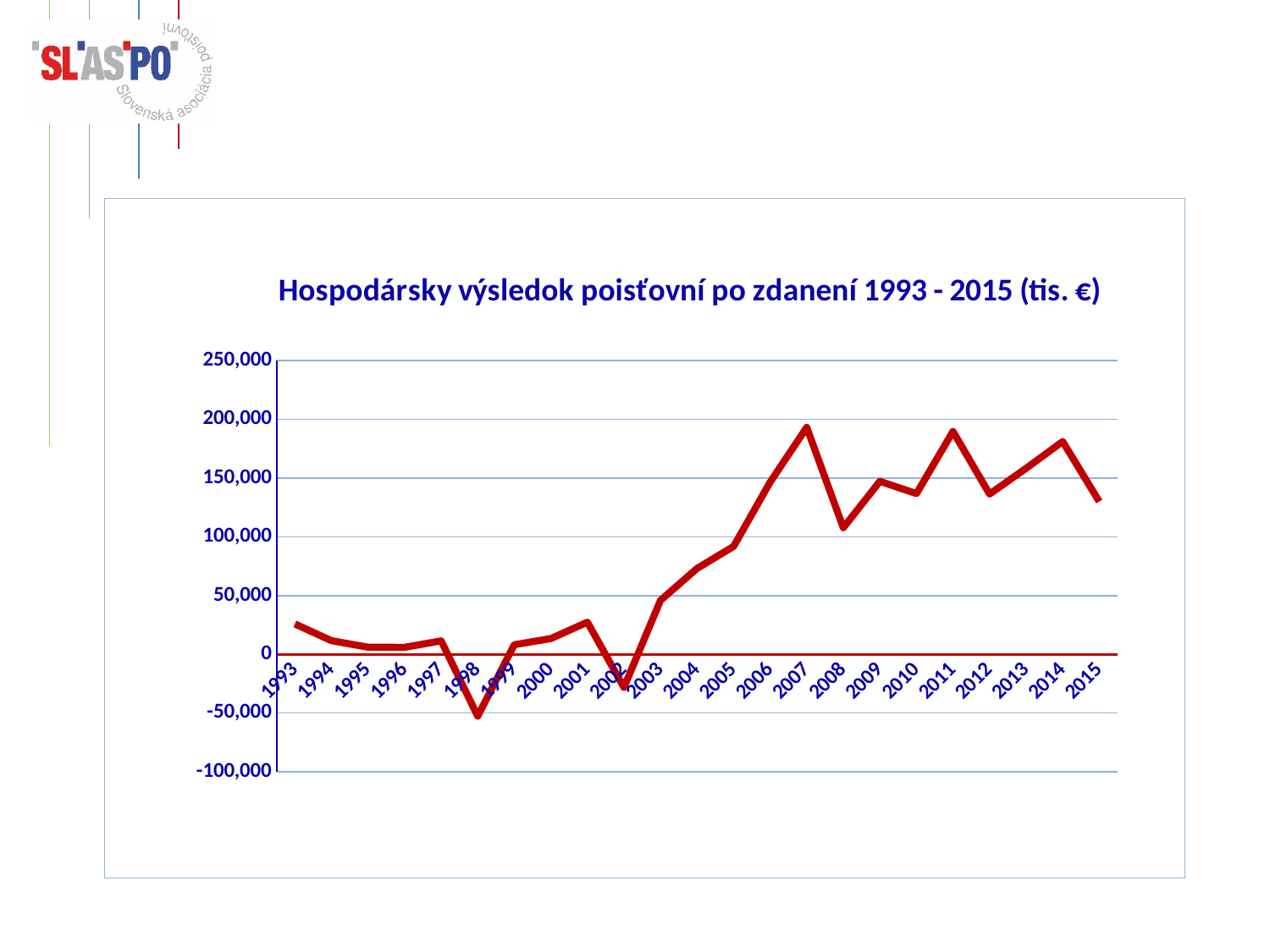
Is the value for 2007 greater or less than 150,000? greater What kind of chart is shown on the slide? line chart Is the value for 2012 greater or less than 150,000? less Is the value for 1998 greater or less than 0? less Which year has the lowest value on the chart? 1998 Do the values rise or fall from 2003 to 2007? rise Which year has the larger value, 2014 or 2015? 2014 What is the title of the chart? Hospodársky výsledok poisťovní po zdanení 1993 - 2015 (tis. €) Which year has the larger value, 2007 or 2008? 2007 How many years are plotted on the x axis of the chart? 23